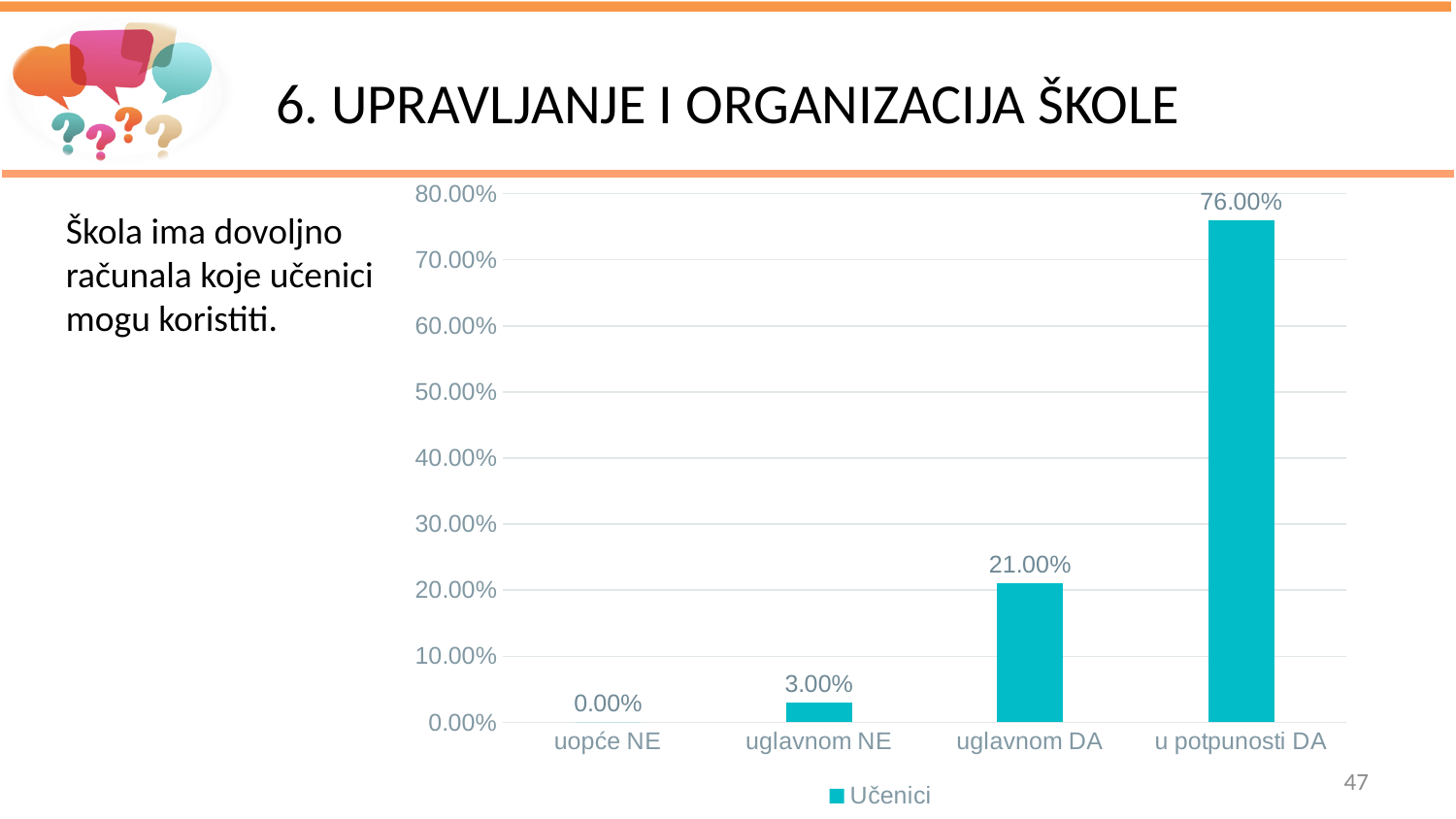
Which is larger, the value for 'uglavnom NE' or the value for 'uglavnom DA'? uglavnom DA How many series does the legend list? 1 Which category has the highest value? u potpunosti DA What is the difference between the values for 'u potpunosti DA' and 'uglavnom DA'? 55.00% What is the value for 'u potpunosti DA'? 76.00% What kind of chart is shown on the slide? bar chart What is the value for 'uglavnom NE'? 3.00% How many categories are shown on the x axis? 4 What is the value for 'uglavnom DA'? 21.00% Which category has the lowest value? uopće NE What is the value for 'uopće NE'? 0.00% Is the value for 'u potpunosti DA' greater or less than 70.00%? greater